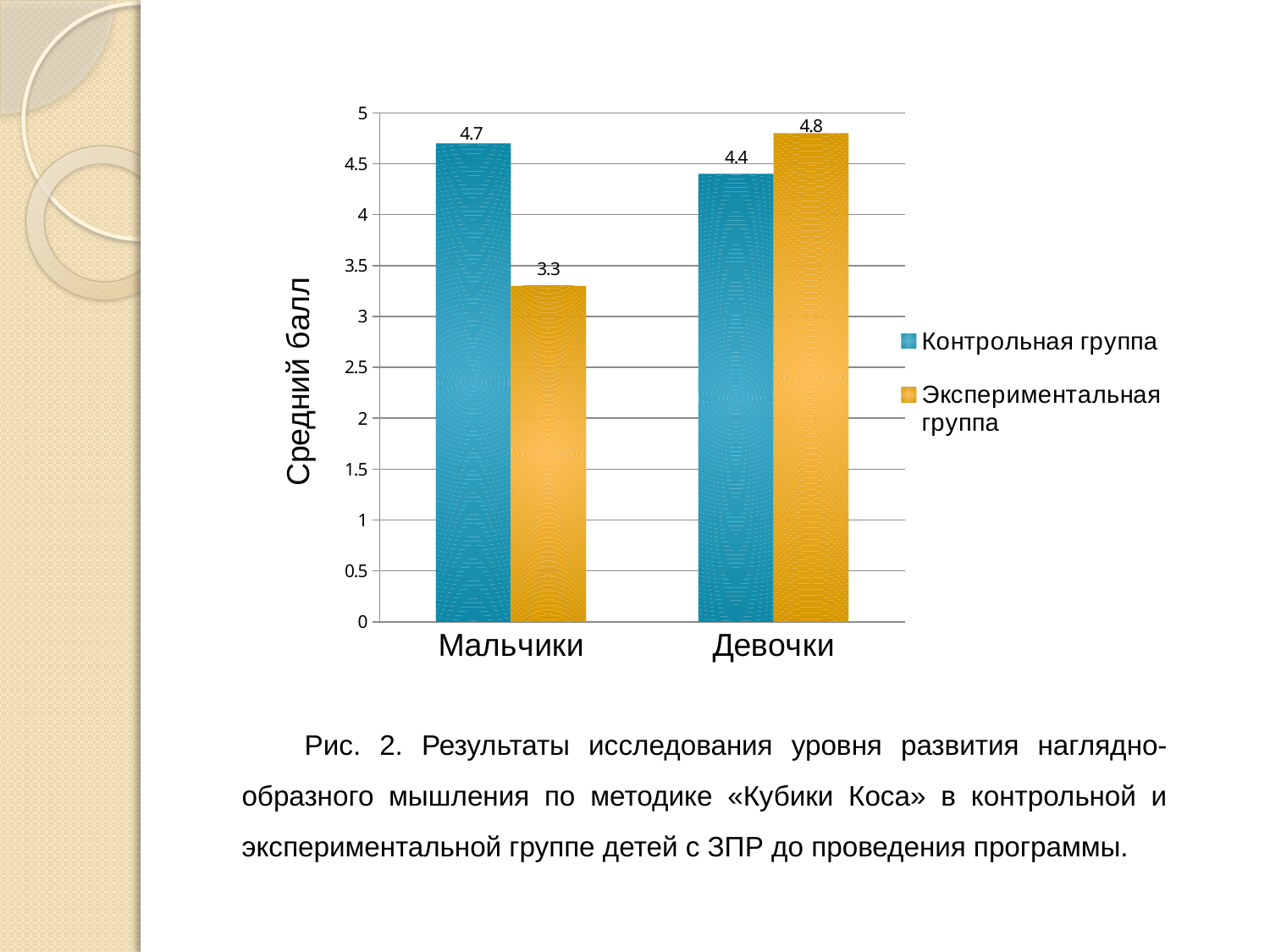
How many series does the legend list? 2 What is the value for Контрольная группа for Девочки? 4.4 What is the value for Экспериментальная группа for Мальчики? 3.3 What is the difference between the Контрольная группа and Экспериментальная группа values for Мальчики? 1.4 What is the value for Контрольная группа for Мальчики? 4.7 What is the value for Экспериментальная группа for Девочки? 4.8 What is the difference between the Экспериментальная группа and Контрольная группа values for Девочки? 0.4 Which category has the highest value for Контрольная группа? Мальчики What kind of chart is shown on the slide? Bar chart For Девочки, which series has the larger value: Контрольная группа or Экспериментальная группа? Экспериментальная группа How many categories are shown on the x axis? 2 Which category has the lowest value for Экспериментальная группа? Мальчики